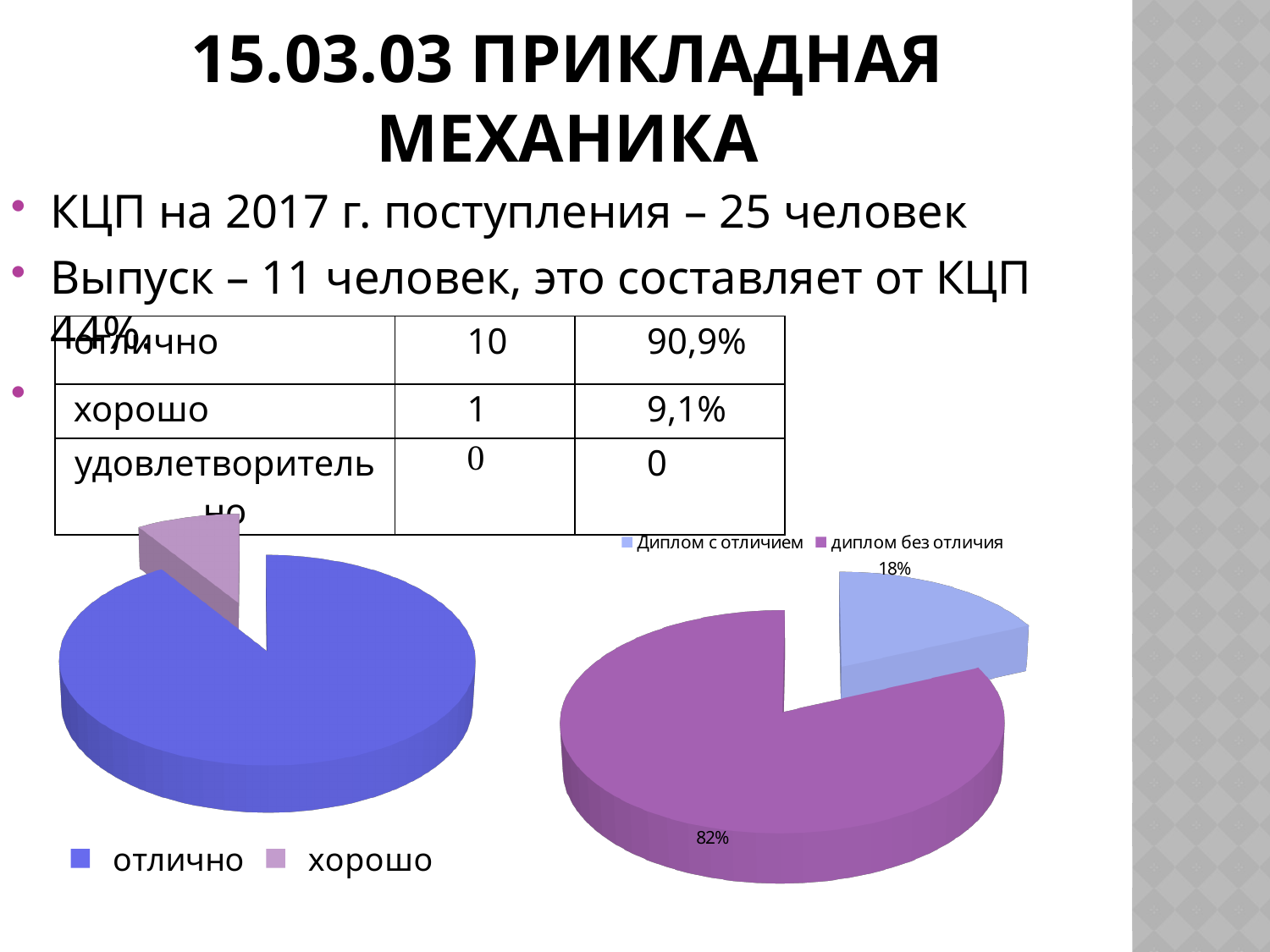
In the right pie chart, what share is labelled for диплом без отличия? 82% In the left pie chart, which category has the smallest slice? хорошо What kind of chart is the right chart on the slide? pie chart In the left pie chart, which slice is larger: отлично or хорошо? отлично In the left pie chart, which category has the largest slice? отлично What kind of chart is the left chart on the slide? pie chart How many categories does the legend of the left pie chart list? 2 In the right pie chart, what is the difference in percentage points between диплом без отличия and Диплом с отличием? 64 In the right pie chart, what colour is the slice for Диплом с отличием? light blue How many slices does the right pie chart have? 2 In the right pie chart, what share is labelled for Диплом с отличием? 18% In the right pie chart, which category has the largest slice? диплом без отличия